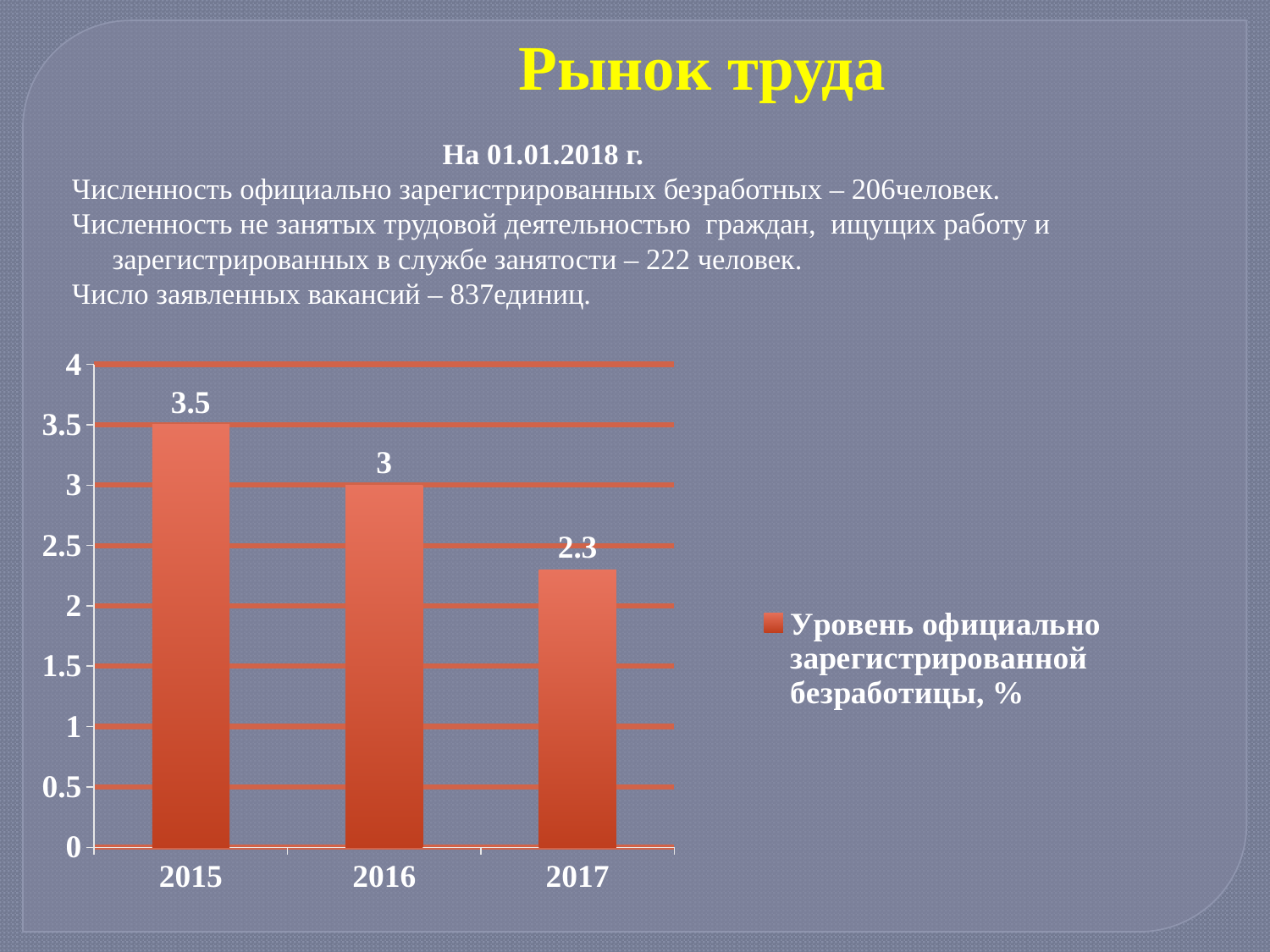
What is the value for 2017 in the chart? 2.3 Which is larger, the value for 2015 or the value for 2016? 2015 Do the values rise or fall from 2015 to 2017? fall What is the difference between the values for 2015 and 2017? 1.2 How many series does the chart legend list? 1 Which year has the highest value in the chart? 2015 What is the difference between the values for 2016 and 2017? 0.7 Which year has the lowest value in the chart? 2017 What kind of chart is shown on the slide? bar chart What is the value for 2016 in the chart? 3 What is the value for 2015 in the chart? 3.5 How many years are shown on the x axis of the chart? 3